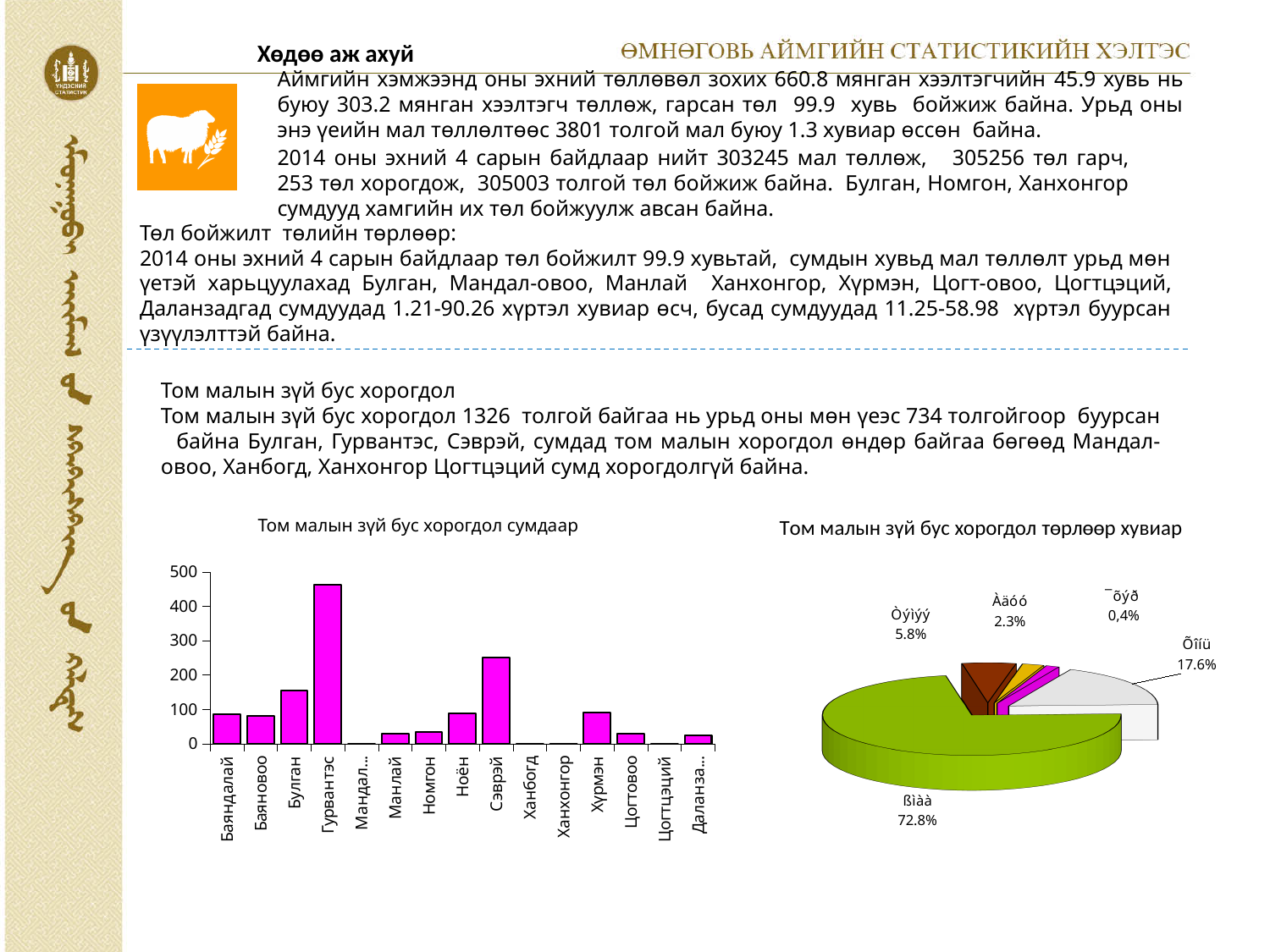
In the bar chart "Том малын зүй бус хорогдол сумдаар", which category has the highest value? Гурвантэс In the pie chart "Том малын зүй бус хорогдол төрлөөр хувиар", what is the share of the largest slice? 72.8% In the bar chart "Том малын зүй бус хорогдол сумдаар", is the value for Сэврэй greater or less than 200? greater What kind of chart is the chart titled "Том малын зүй бус хорогдол сумдаар"? bar chart In the pie chart "Том малын зүй бус хорогдол төрлөөр хувиар", how many slices are there? 5 In the bar chart "Том малын зүй бус хорогдол сумдаар", is the value for Булган greater or less than 100? greater In the bar chart "Том малын зүй бус хорогдол сумдаар", is the value for Баяндалай greater or less than 100? less In the bar chart "Том малын зүй бус хорогдол сумдаар", what is the highest value shown on the vertical axis? 500 In the bar chart "Том малын зүй бус хорогдол сумдаар", which is larger, the value for Гурвантэс or the value for Сэврэй? Гурвантэс What kind of chart is the chart titled "Том малын зүй бус хорогдол төрлөөр хувиар"? pie chart In the bar chart "Том малын зүй бус хорогдол сумдаар", which is larger, the value for Булган or the value for Баяновоо? Булган